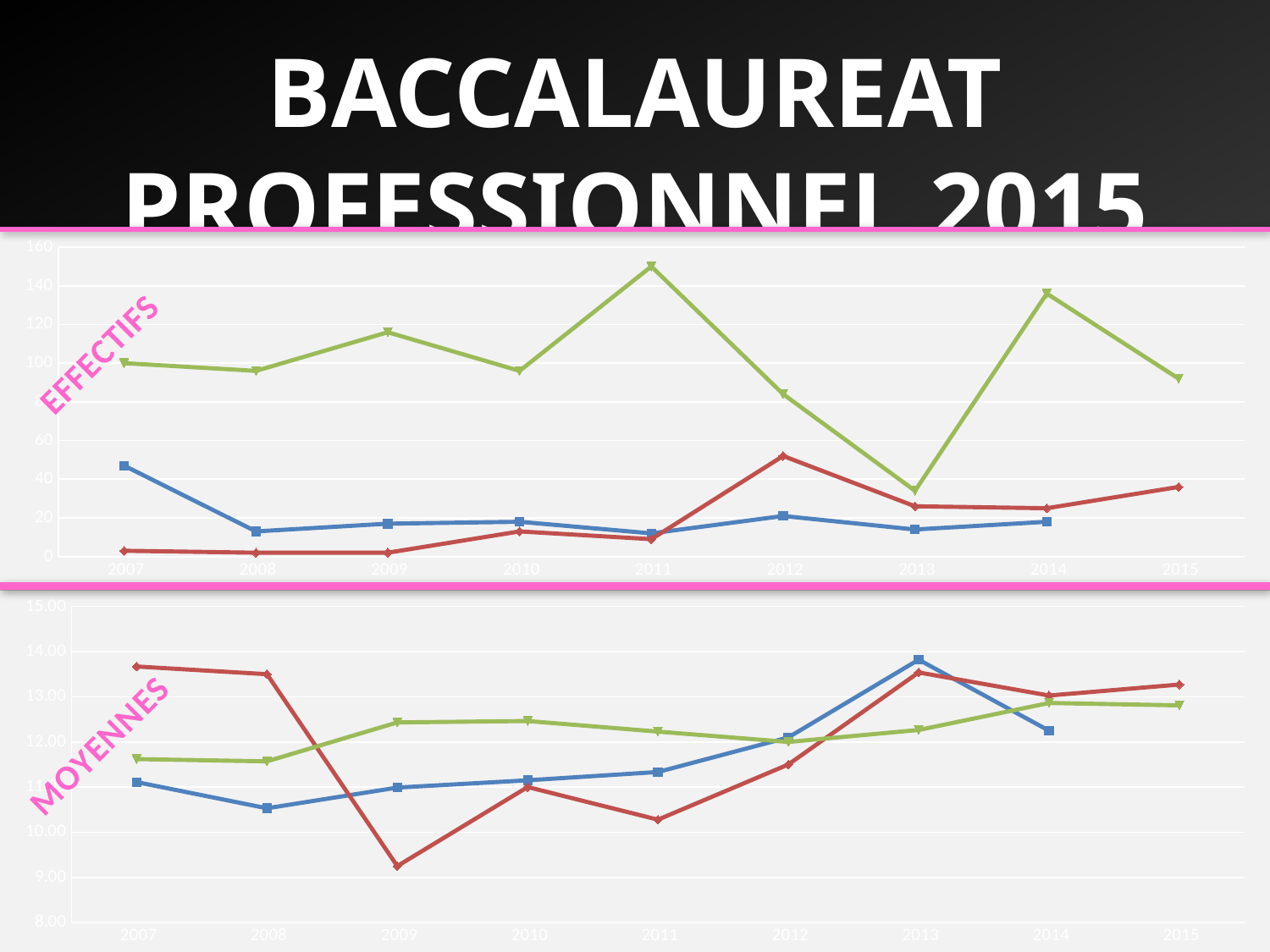
In the top chart (EFFECTIFS), is the value of the red line in 2012 greater or less than 40? greater In the top chart (EFFECTIFS), in which year does the green line reach its lowest value? 2013 In the bottom chart (MOYENNES), in which year does the blue line reach its highest value? 2013 In the top chart (EFFECTIFS), in which year does the blue line reach its highest value? 2007 In the bottom chart (MOYENNES), is the value of the red line in 2009 greater or less than 10.00? less In the bottom chart (MOYENNES), in which year does the red line reach its lowest value? 2009 What kind of chart is the top chart labelled EFFECTIFS? line chart In the top chart (EFFECTIFS), in which year does the green line reach its highest value? 2011 In the top chart (EFFECTIFS), which line has the larger value in 2011, the green line or the red line? green line How many years are shown on the x axis of the bottom chart (MOYENNES)? 9 In the top chart (EFFECTIFS), is the value of the green line in 2011 greater or less than 140? greater In the bottom chart (MOYENNES), does the red line rise or fall from 2008 to 2009? fall